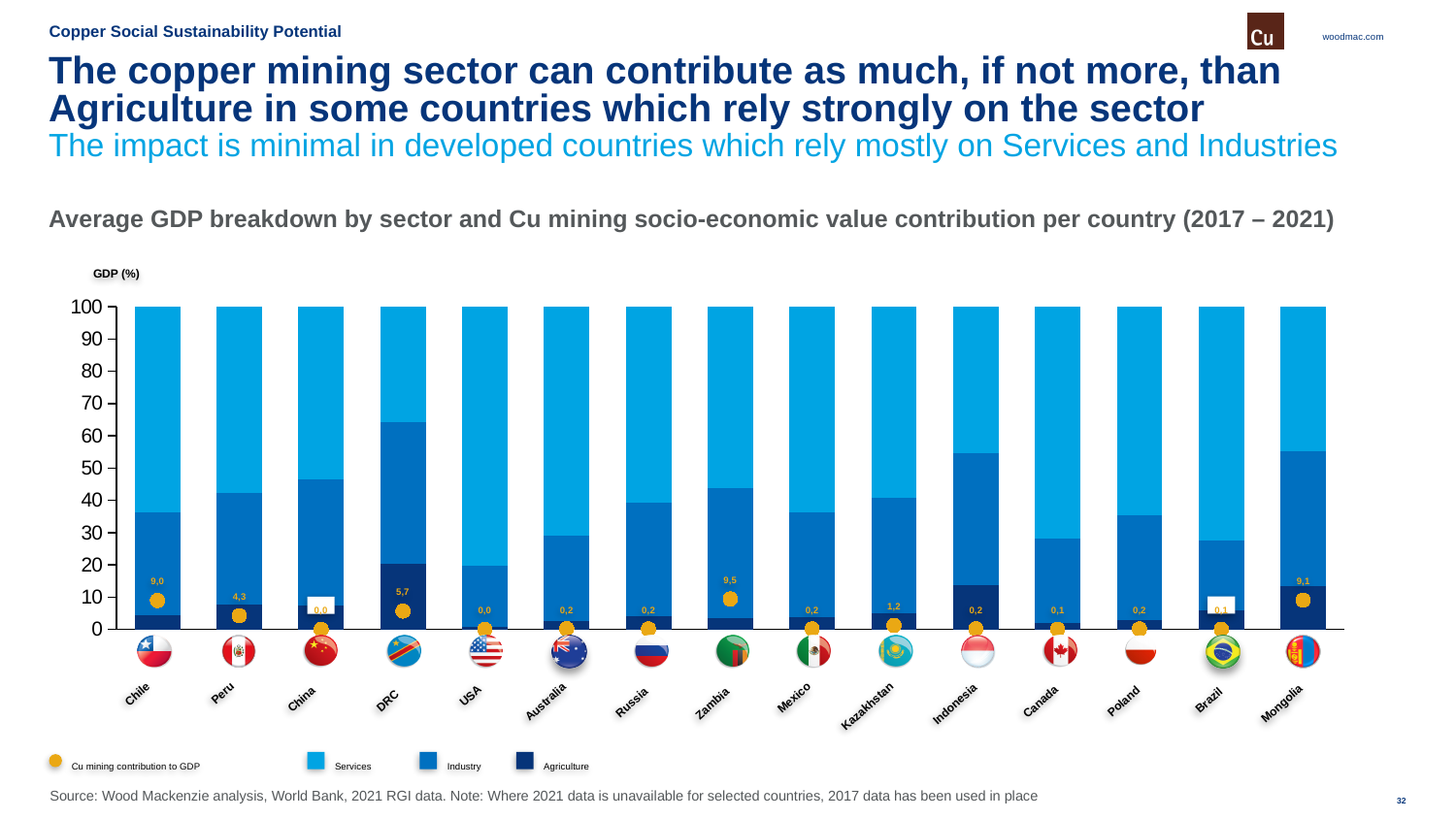
What is the Cu mining contribution to GDP shown for Kazakhstan? 1,2 What is the difference between the Cu mining contribution to GDP for Chile and for Peru? 4,7 Is the Services share of GDP for USA greater or less than 70? greater What is the Cu mining contribution to GDP shown for Chile? 9,0 How many entries does the legend list? 4 How many countries are shown on the chart? 15 What kind of chart is shown on the slide? Stacked bar chart Which has a larger Cu mining contribution to GDP, DRC or Peru? DRC What is the Cu mining contribution to GDP shown for Zambia? 9,5 Is the Services share of GDP for DRC greater or less than 40? less What is the title of the chart? Average GDP breakdown by sector and Cu mining socio-economic value contribution per country (2017 – 2021) Which country has the highest Cu mining contribution to GDP? Zambia